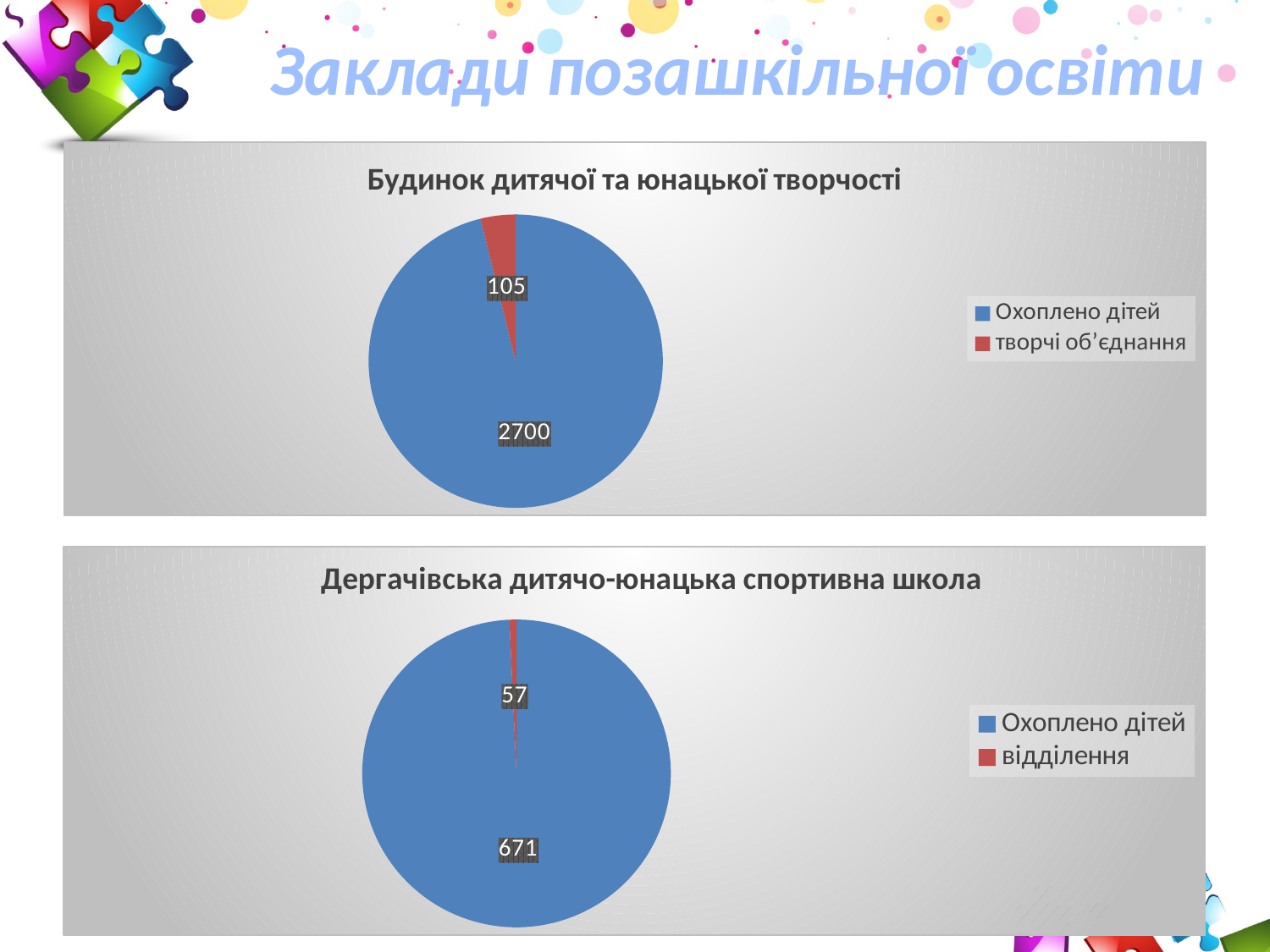
How many categories does the legend of the top chart list? 2 In the chart titled "Дергачівська дитячо-юнацька спортивна школа", what is the value for "відділення"? 57 In the chart titled "Будинок дитячої та юнацької творчості", what is the value for "творчі об’єднання"? 105 In the chart titled "Будинок дитячої та юнацької творчості", what is the value for "Охоплено дітей"? 2700 What type of chart is the chart titled "Дергачівська дитячо-юнацька спортивна школа"? Pie chart In the chart titled "Дергачівська дитячо-юнацька спортивна школа", what is the value for "Охоплено дітей"? 671 Which is larger: "Охоплено дітей" in the top chart or "Охоплено дітей" in the bottom chart? Top chart (2700) What is the title of the bottom chart? Дергачівська дитячо-юнацька спортивна школа In the top chart, what is the difference between the values for "Охоплено дітей" and "творчі об’єднання"? 2595 In the bottom chart, what is the difference between the values for "Охоплено дітей" and "відділення"? 614 In the top chart, which category has the largest slice? Охоплено дітей In the bottom chart, which category has the smallest slice? відділення